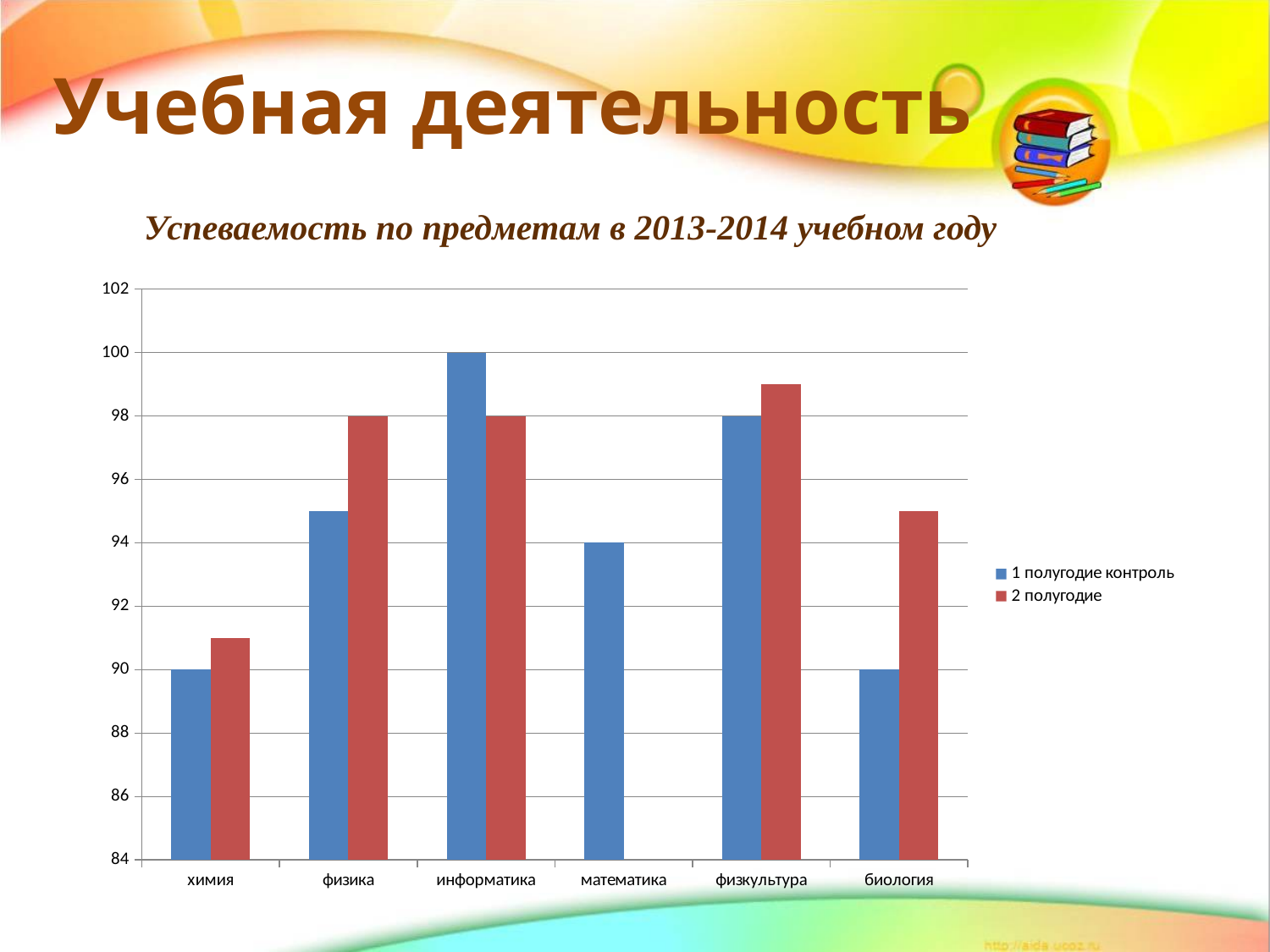
Which subject has the highest value in the series '1 полугодие контроль'? информатика What is the difference between the '1 полугодие контроль' and '2 полугодие' values for информатика? 2 What is the title of the chart? Успеваемость по предметам в 2013-2014 учебном году What is the value for математика in the series '1 полугодие контроль'? 94 How many series does the chart legend list? 2 For информатика, which series has the larger value: '1 полугодие контроль' or '2 полугодие'? 1 полугодие контроль What type of chart is shown on the slide? bar chart Is the value for физкультура in the series '2 полугодие' greater or less than 98? greater What is the value for физика in the series '2 полугодие'? 98 What is the value for информатика in the series '1 полугодие контроль'? 100 How many subjects (categories) are shown on the x axis of the chart? 6 What is the value for химия in the series '1 полугодие контроль'? 90